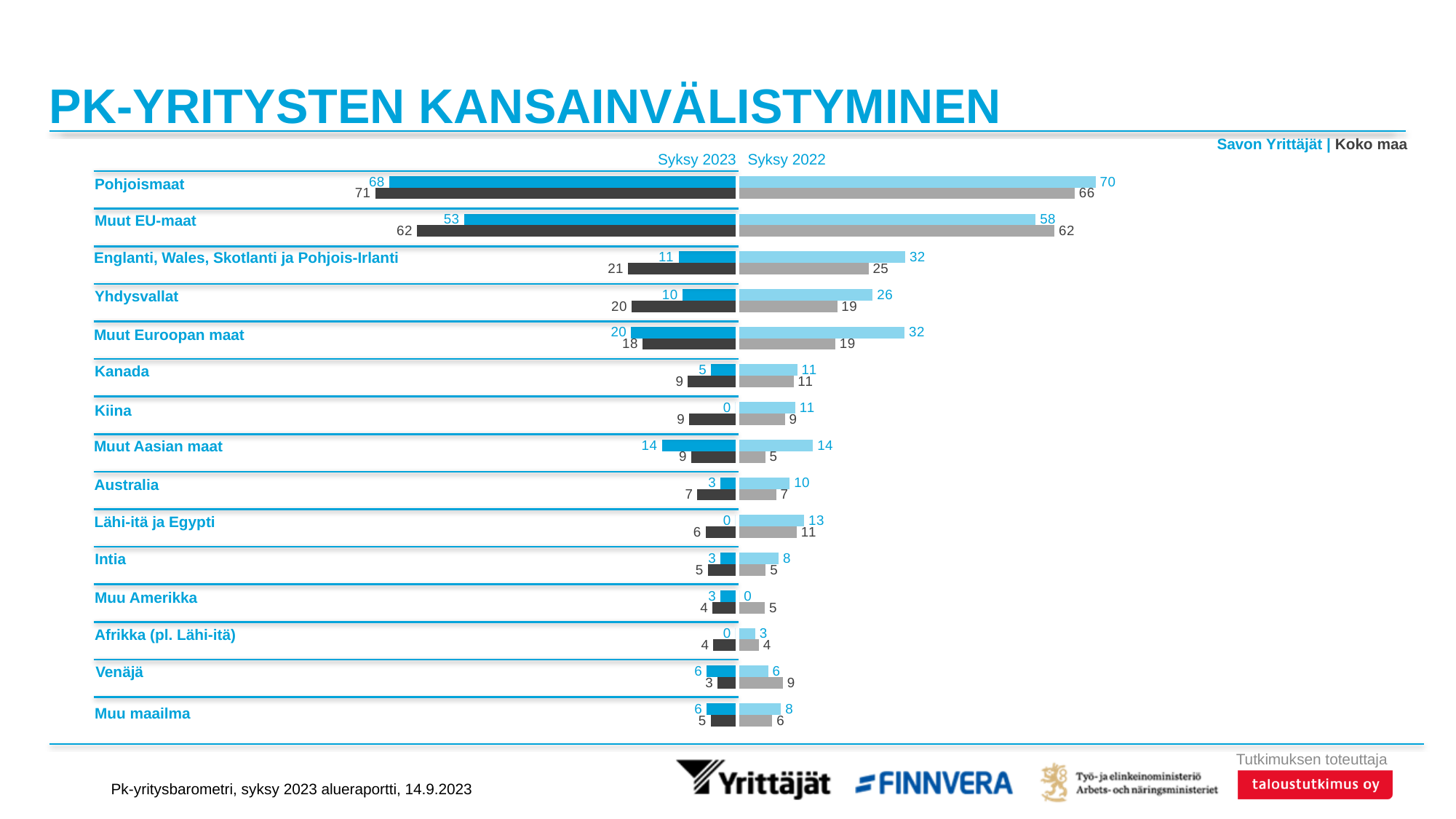
What is the Savon Yrittäjät value for Pohjoismaat in Syksy 2023? 68 What is the Koko maa value for Muut EU-maat in Syksy 2022? 62 What is the difference between the Koko maa values for Pohjoismaat in Syksy 2023 and Syksy 2022? 5 What is the difference between the Savon Yrittäjät and Koko maa values for Muut EU-maat in Syksy 2023? 9 How many series does the legend list? 2 What is the Koko maa value for Yhdysvallat in Syksy 2023? 20 What kind of chart is shown on the slide? Bar chart In Syksy 2023, which is larger for Muut Aasian maat: the Savon Yrittäjät value or the Koko maa value? Savon Yrittäjät How many regions are listed in the chart? 15 What is the Savon Yrittäjät value for Englanti, Wales, Skotlanti ja Pohjois-Irlanti in Syksy 2022? 32 In Syksy 2022, which is larger for Venäjä: the Savon Yrittäjät value or the Koko maa value? Koko maa Which region has the highest Savon Yrittäjät value in Syksy 2023? Pohjoismaat